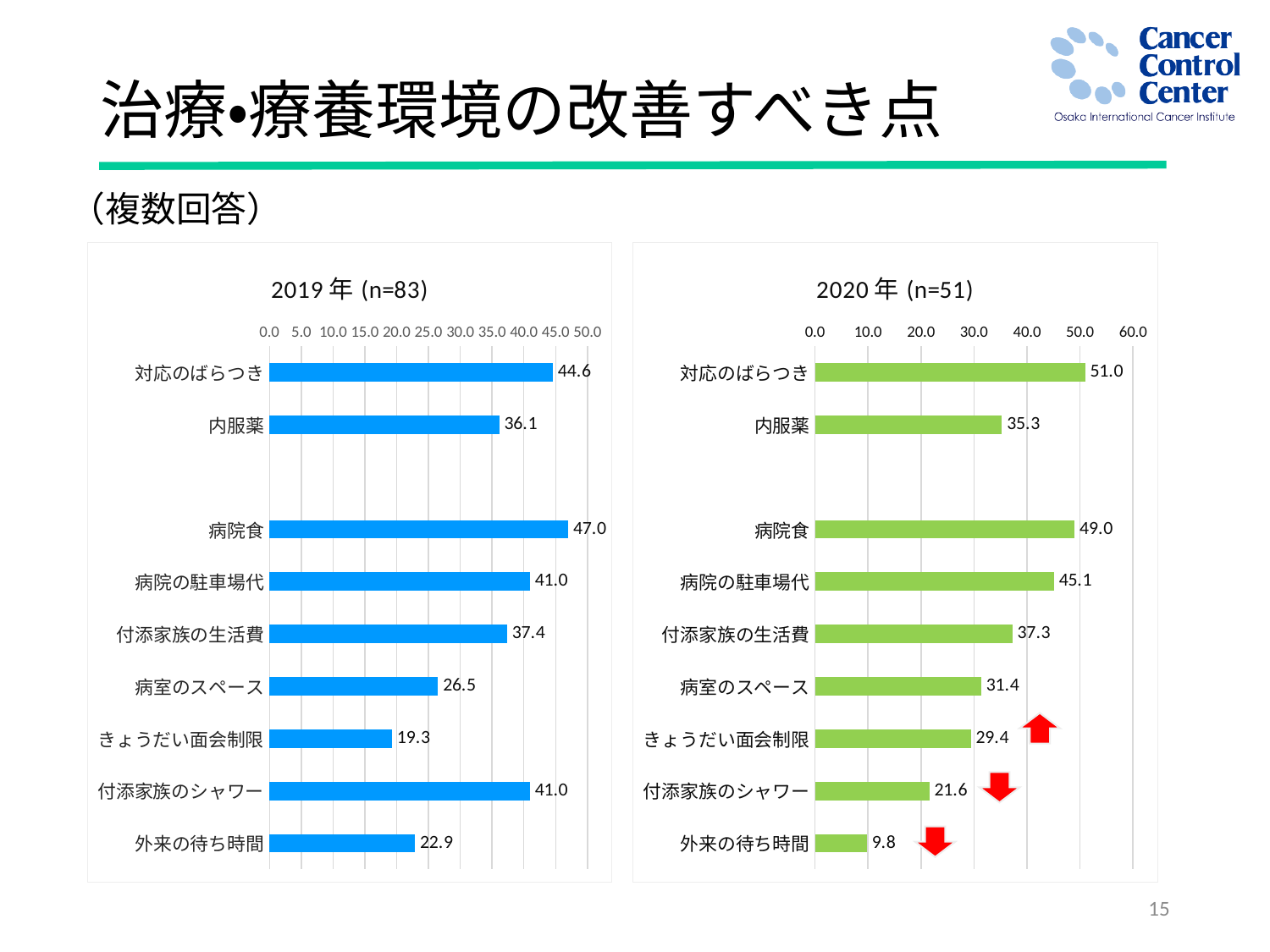
In the 2019年 (n=83) chart, what is the value for 付添家族のシャワー? 41.0 What colour are the bars in the 2020年 (n=51) chart? green In the 2019年 (n=83) chart, what is the value for 病院食? 47.0 In the 2020年 (n=51) chart, which is larger: 病院の駐車場代 or 付添家族の生活費? 病院の駐車場代 In the 2019年 (n=83) chart, which category has the highest value? 病院食 What type of chart is the 2020年 (n=51) chart? bar chart In the 2020年 (n=51) chart, what is the value for 外来の待ち時間? 9.8 In the 2019年 (n=83) chart, is the value for 病室のスペース greater or less than 30.0? less In the 2019年 (n=83) chart, what is the difference between 病院食 and 外来の待ち時間? 24.1 In the 2019年 (n=83) chart, which category has the lowest value? きょうだい面会制限 In the 2020年 (n=51) chart, which category has the highest value? 対応のばらつき In the 2020年 (n=51) chart, what is the difference between 対応のばらつき and 内服薬? 15.7